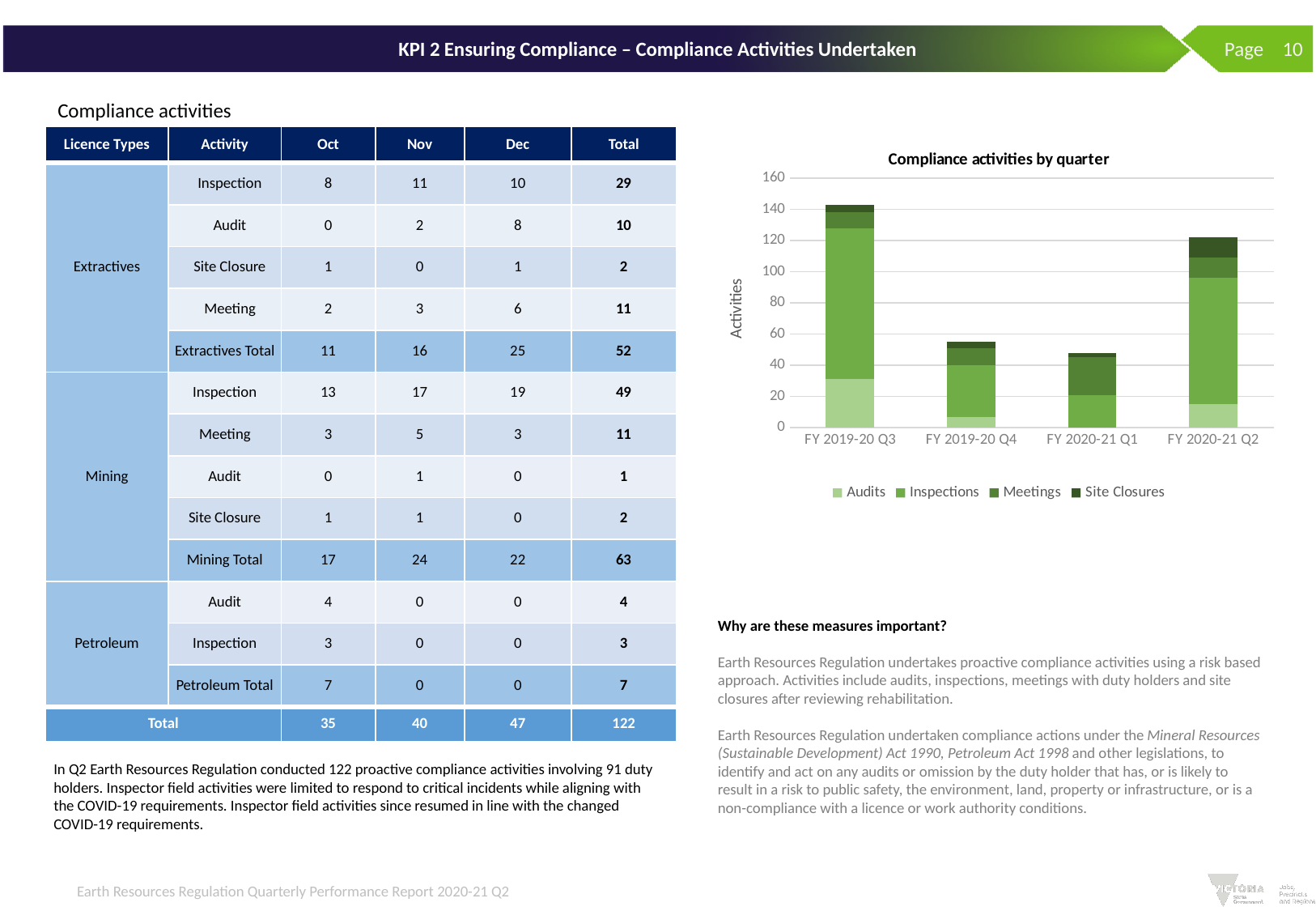
In the 'Compliance activities by quarter' chart, is the total for FY 2020-21 Q1 greater or less than 60? less How many series does the legend of the 'Compliance activities by quarter' chart list? 4 How many quarters are shown on the x axis of the 'Compliance activities by quarter' chart? 4 In the 'Compliance activities by quarter' chart, is the total for FY 2019-20 Q3 greater or less than 120? greater What kind of chart is 'Compliance activities by quarter'? Stacked bar chart What is the label on the y axis of the 'Compliance activities by quarter' chart? Activities In the 'Compliance activities by quarter' chart, which has the larger total: FY 2019-20 Q3 or FY 2020-21 Q2? FY 2019-20 Q3 What are the legend entries of the 'Compliance activities by quarter' chart? Audits, Inspections, Meetings, Site Closures In the 'Compliance activities by quarter' chart, is the total for FY 2020-21 Q2 greater or less than 100? greater In the 'Compliance activities by quarter' chart, which has the larger total: FY 2019-20 Q4 or FY 2020-21 Q2? FY 2020-21 Q2 Which quarter has the tallest stacked bar in the 'Compliance activities by quarter' chart? FY 2019-20 Q3